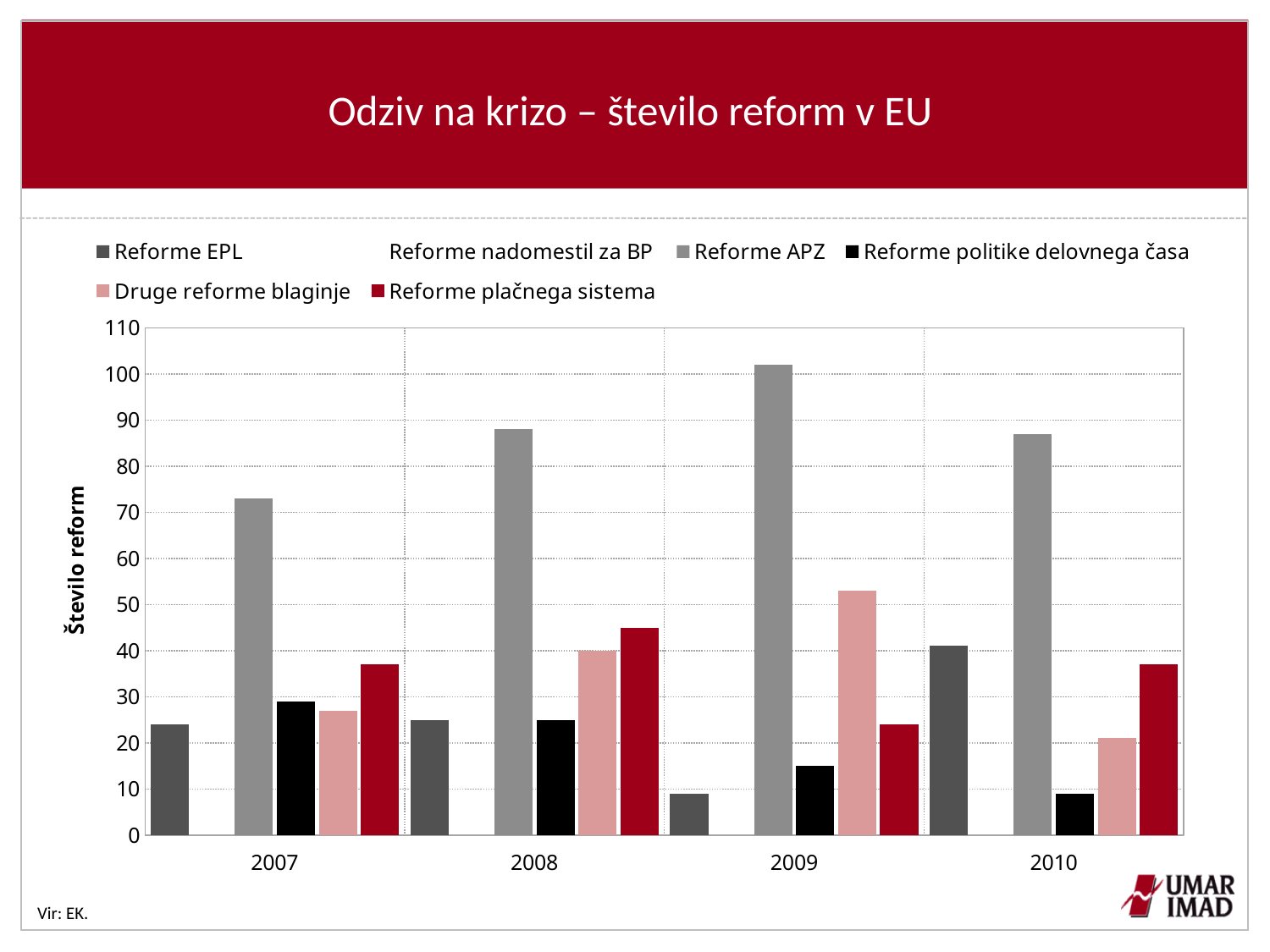
Is the value for Druge reforme blaginje in 2009 greater or less than 50? greater What kind of chart is shown on the slide? bar chart How many years are shown on the x axis? 4 How many series does the legend list? 6 In which year is the value for Reforme EPL lowest? 2009 In which year is the value for Reforme APZ highest? 2009 Is the value for Reforme APZ in 2007 greater or less than 60? greater In 2009, which is larger: Druge reforme blaginje or Reforme plačnega sistema? Druge reforme blaginje In which year is the value for Druge reforme blaginje highest? 2009 Do the values for Reforme politike delovnega časa rise or fall from 2007 to 2010? fall In which year is the value for Reforme plačnega sistema highest? 2008 Is the value for Reforme EPL in 2009 greater or less than 20? less